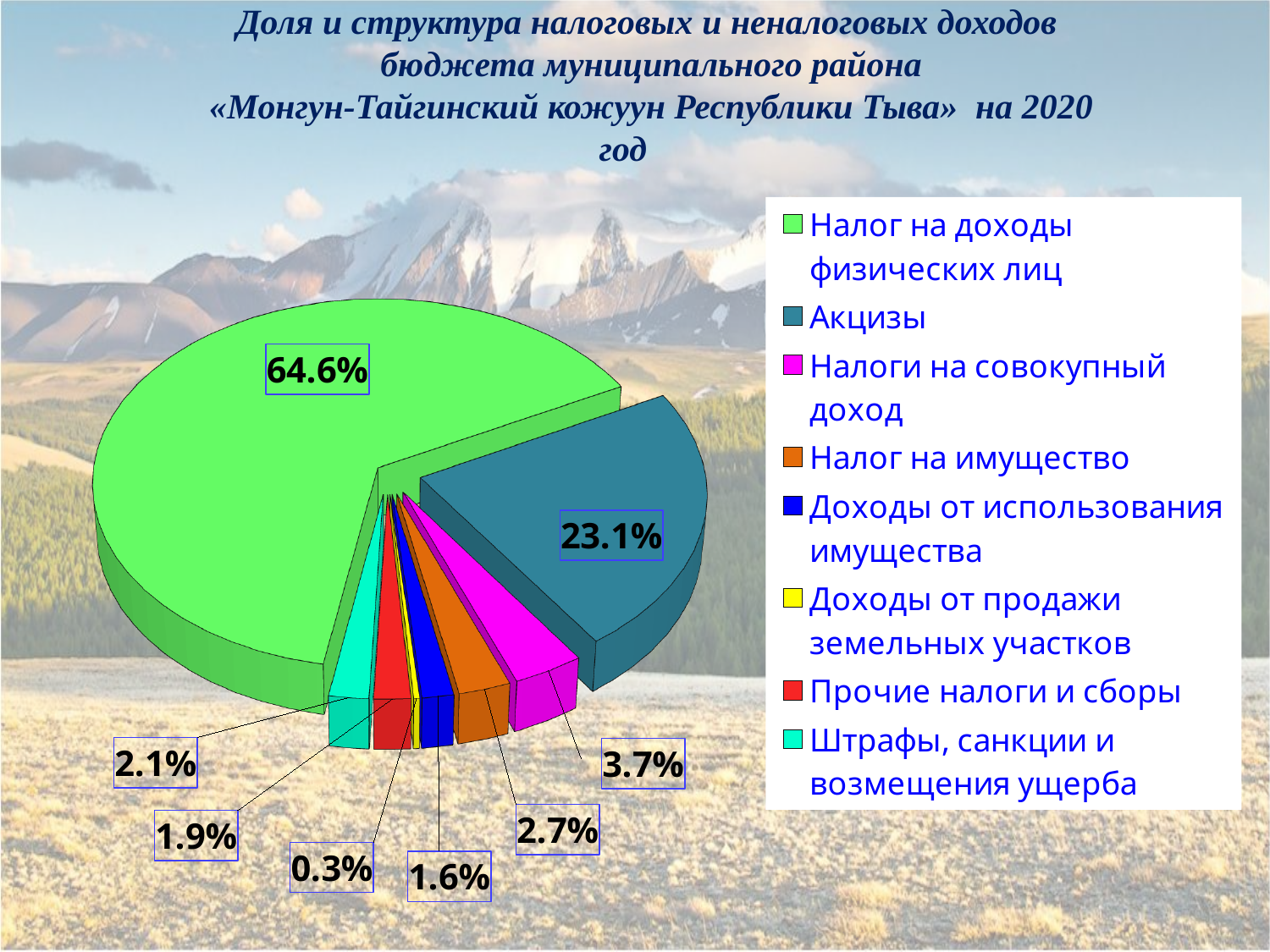
How many categories does the legend list? 8 What share of the pie is labelled for Налог на имущество? 2.7% What share of the pie is labelled for Акцизы? 23.1% What share of the pie is labelled for Штрафы, санкции и возмещения ущерба? 2.1% What type of chart is shown on the slide? pie chart What is the difference between the shares of Налог на доходы физических лиц and Акцизы? 41.5% What share of the pie is labelled for Налог на доходы физических лиц? 64.6% What share of the pie is labelled for Налоги на совокупный доход? 3.7% What share of the pie is labelled for Доходы от продажи земельных участков? 0.3% Which is larger: the share of Прочие налоги и сборы or the share of Доходы от использования имущества? Прочие налоги и сборы Which category has the largest share of the pie? Налог на доходы физических лиц Which category has the smallest share of the pie? Доходы от продажи земельных участков